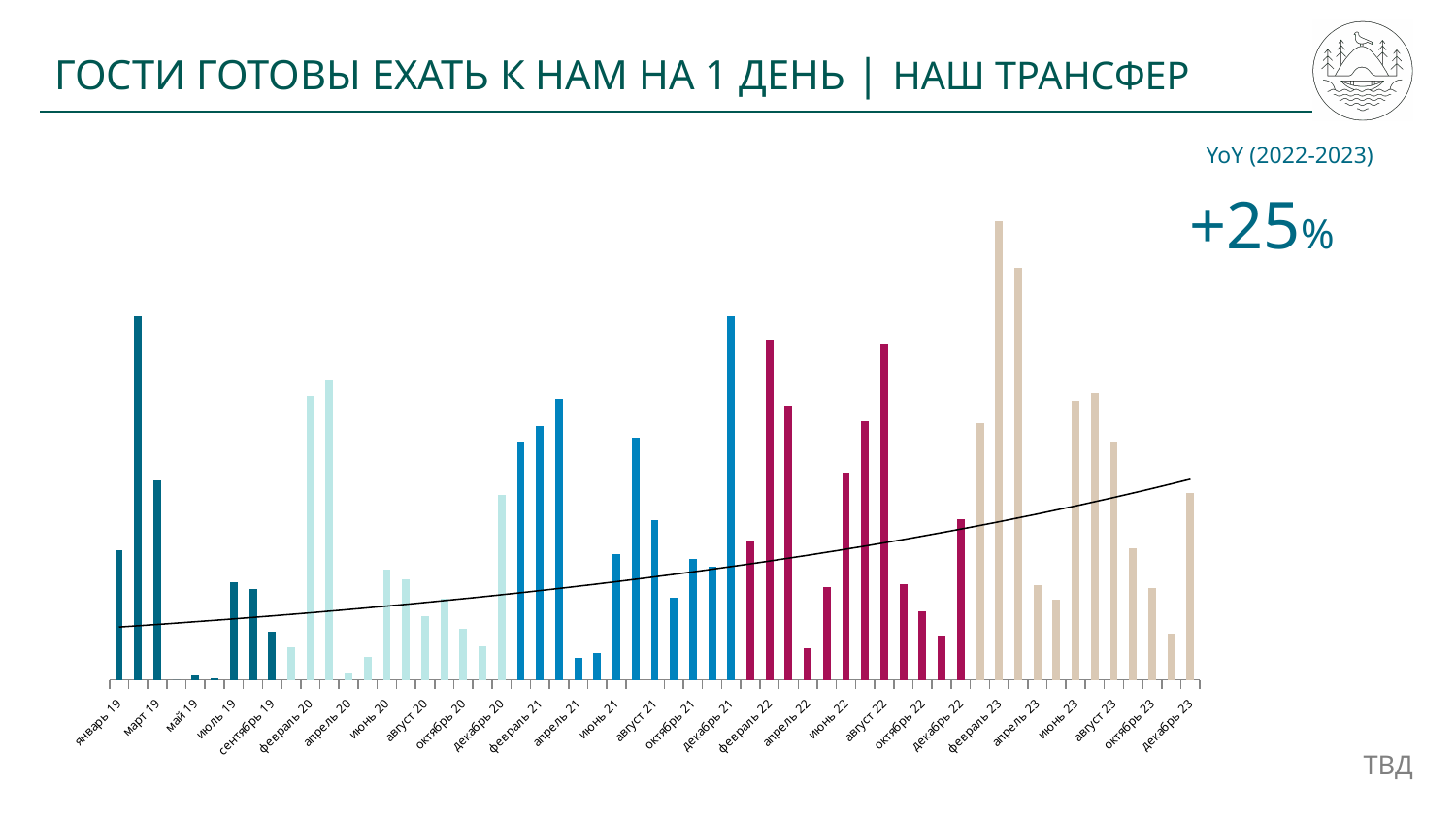
Which period does the YoY figure on the slide refer to? 2022-2023 What kind of chart is shown on the slide? bar chart What is the title of the slide containing the chart? ГОСТИ ГОТОВЫ ЕХАТЬ К НАМ НА 1 ДЕНЬ | НАШ ТРАНСФЕР Does the trend line drawn across the chart rise or fall from left to right? rise What year-over-year (YoY) change for 2022-2023 is printed on the slide? +25%